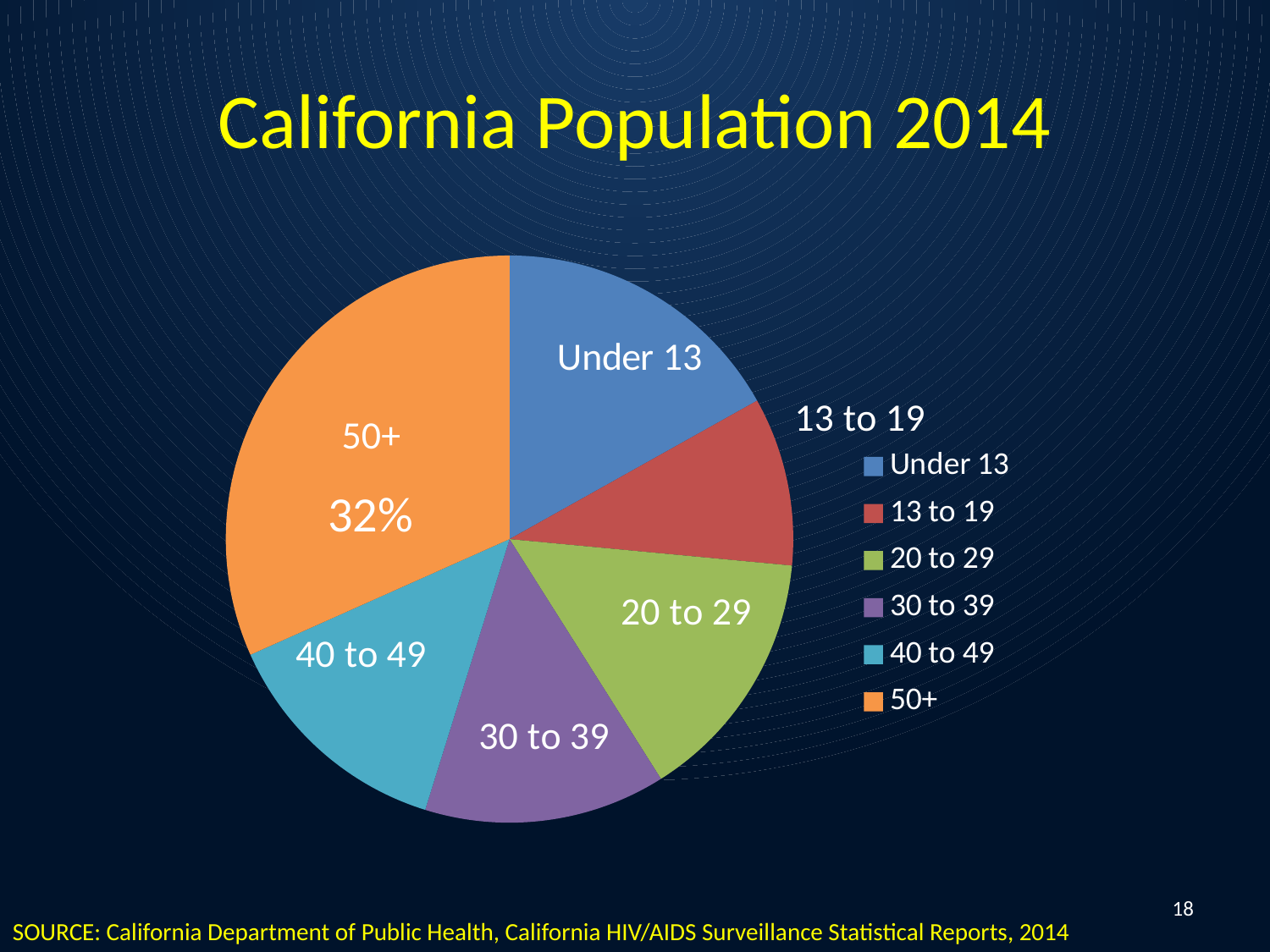
What kind of chart is shown on the slide? pie chart What share of the pie does the 50+ slice represent? 32% What colour is the 50+ slice? orange Which age group has the largest slice of the pie? 50+ Which age group has the smallest slice of the pie? 13 to 19 How many slices does the pie chart have? 6 Which slice is larger, Under 13 or 13 to 19? Under 13 What is the title of the chart? California Population 2014 How many entries does the legend list? 6 Which slice is larger, 50+ or Under 13? 50+